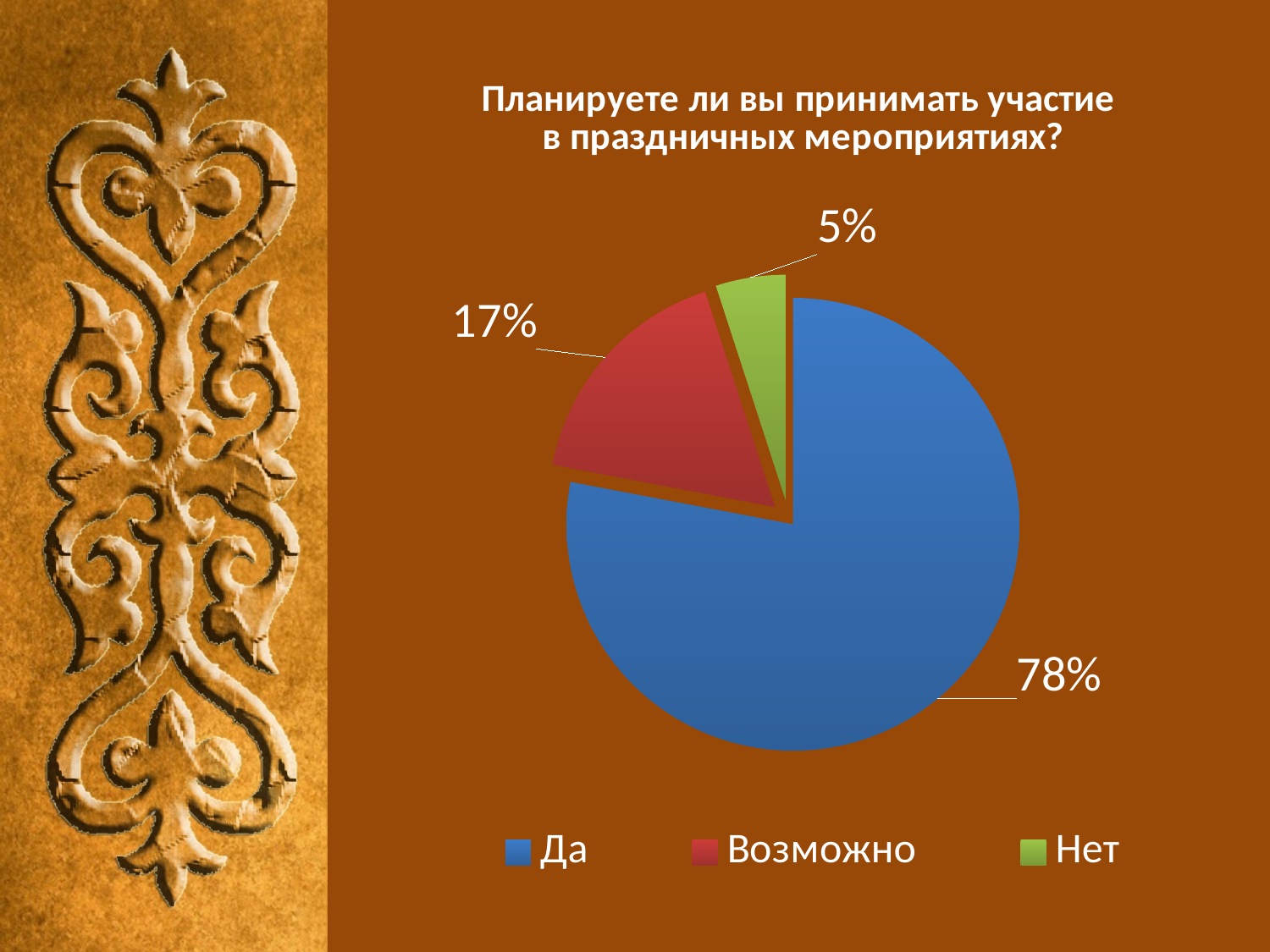
Which answer has the smallest share of the pie? Нет Which is larger, the share for "Возможно" or the share for "Нет"? Возможно What is the difference in percentage points between "Да" and "Возможно"? 61 What is the difference in percentage points between "Возможно" and "Нет"? 12 What is the title of the chart? Планируете ли вы принимать участие в праздничных мероприятиях? What colour is the slice for "Нет"? green What percentage of respondents answered "Возможно"? 17% Which answer has the largest share of the pie? Да How many slices does the pie chart have? 3 What percentage of respondents answered "Да"? 78% What kind of chart is shown on the slide? pie chart What percentage of respondents answered "Нет"? 5%